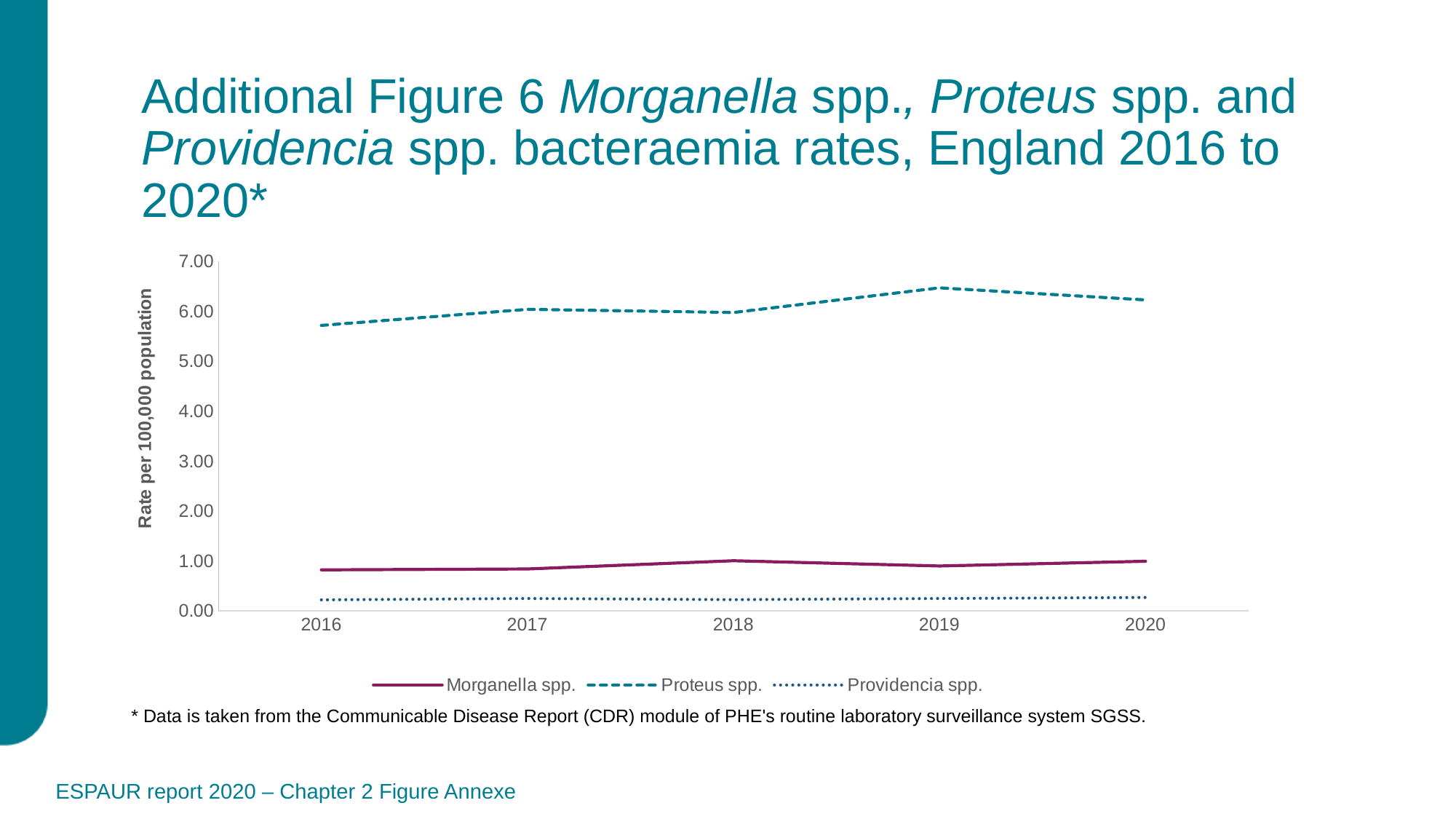
How many series does the legend list? 3 Which is larger in 2018, the Proteus spp. rate or the Morganella spp. rate? Proteus spp. In which year is the Proteus spp. rate highest? 2019 What kind of chart is shown on the slide? line chart In which year is the Proteus spp. rate lowest? 2016 Is the Morganella spp. rate in 2016 greater or less than 1.00? less What is the label on the y axis? Rate per 100,000 population Is the Proteus spp. rate in 2016 greater or less than 6.00? less Which series has the lowest rate across all years? Providencia spp. How many years are plotted along the x axis? 5 Is the Proteus spp. rate in 2019 greater or less than 6.00? greater Which series has the highest rate across all years? Proteus spp.